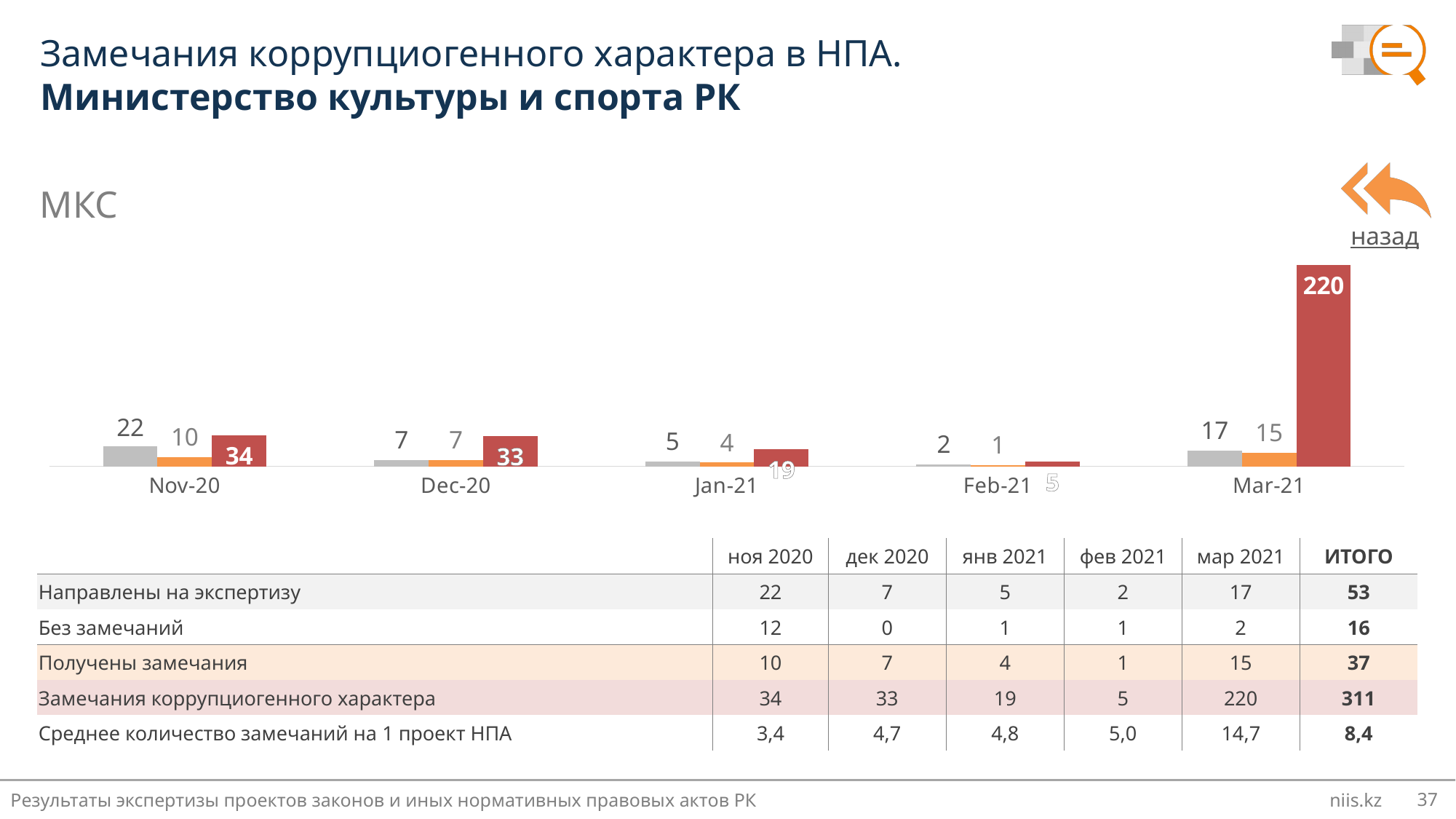
What type of chart is shown on the slide? bar chart What is the value of the grey bar for Nov-20? 22 What is the difference between the grey and orange bar values for Nov-20? 12 What is the value of the red bar for Mar-21? 220 Which is larger: the grey bar for Nov-20 or the grey bar for Mar-21? Nov-20 How many months (categories) are shown on the x axis of the chart? 5 Which month has the lowest grey bar? Feb-21 What is the value of the red bar for Dec-20? 33 What is the value of the orange bar for Jan-21? 4 What is the difference between the red bar values for Mar-21 and Nov-20? 186 Do the grey bar values rise or fall from Nov-20 to Feb-21? fall Which month has the highest red bar? Mar-21